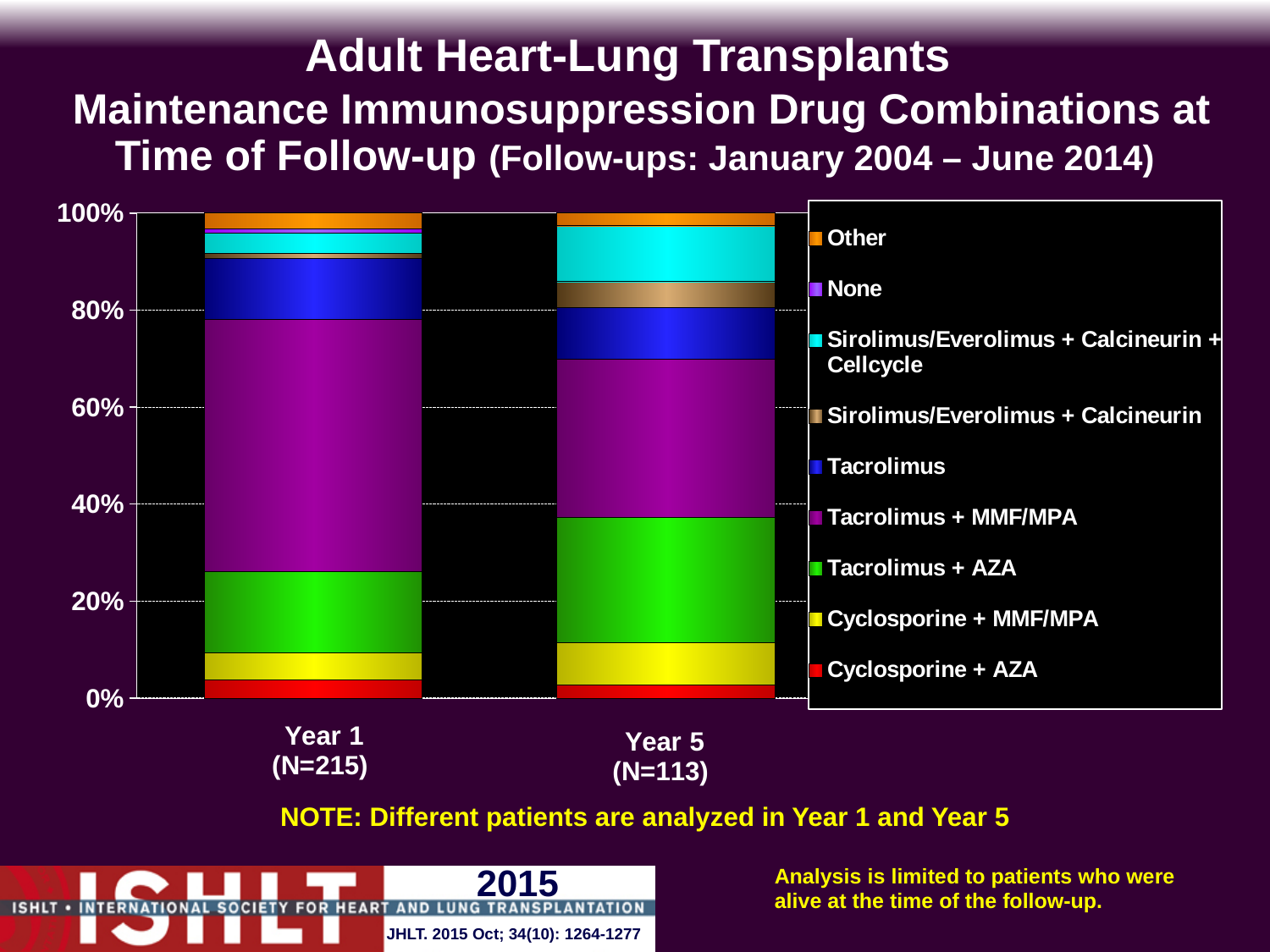
Which drug combination makes up the largest segment of the Year 5 bar? Tacrolimus + MMF/MPA What is the N (number of patients) shown for the Year 5 bar? N=113 Is the share of Tacrolimus + MMF/MPA in the Year 5 bar greater or less than 40%? less Which drug combination makes up the largest segment of the Year 1 bar? Tacrolimus + MMF/MPA How many bars (follow-up time points) are plotted in the chart? 2 Which drug combination series is at the bottom of each stacked bar? Cyclosporine + AZA Is the share of Tacrolimus + AZA larger in Year 1 or Year 5? Year 5 Is the share of Tacrolimus + MMF/MPA larger in Year 1 or Year 5? Year 1 Is the share of Sirolimus/Everolimus + Calcineurin + Cellcycle larger in Year 1 or Year 5? Year 5 How many drug combination series does the legend list? 9 What kind of chart is shown on the slide? Stacked bar chart Is the share of Tacrolimus + MMF/MPA in the Year 1 bar greater or less than 40%? greater